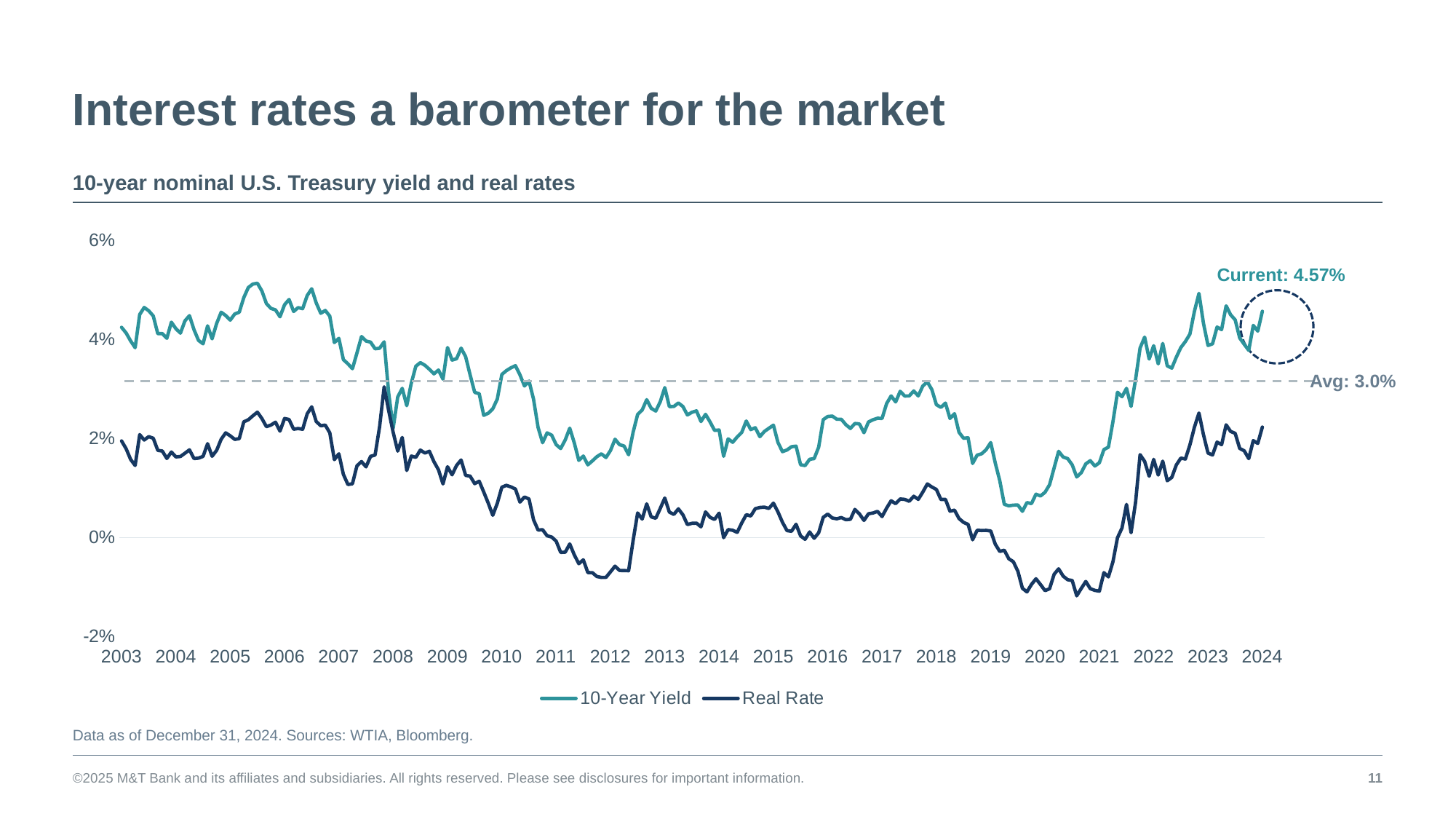
Which is larger, the current 10-Year Yield or the average shown by the dashed line? Current 10-Year Yield (4.57%) What are the two series named in the legend? 10-Year Yield and Real Rate What average value is marked by the dashed horizontal line? 3.0% By how much does the current 10-Year Yield of 4.57% exceed the 3.0% average? 1.57 percentage points What kind of chart is shown on the slide? Line chart What is the current 10-Year Yield labelled on the chart? 4.57% What is the chart's title? 10-year nominal U.S. Treasury yield and real rates Does the 10-Year Yield rise or fall from 2021 to 2023? rise How many series does the legend list? 2 Is the Real Rate during 2020 greater or less than 0%? less How many year labels are shown on the x axis? 22 Is the 10-Year Yield during 2006 greater or less than 4%? greater